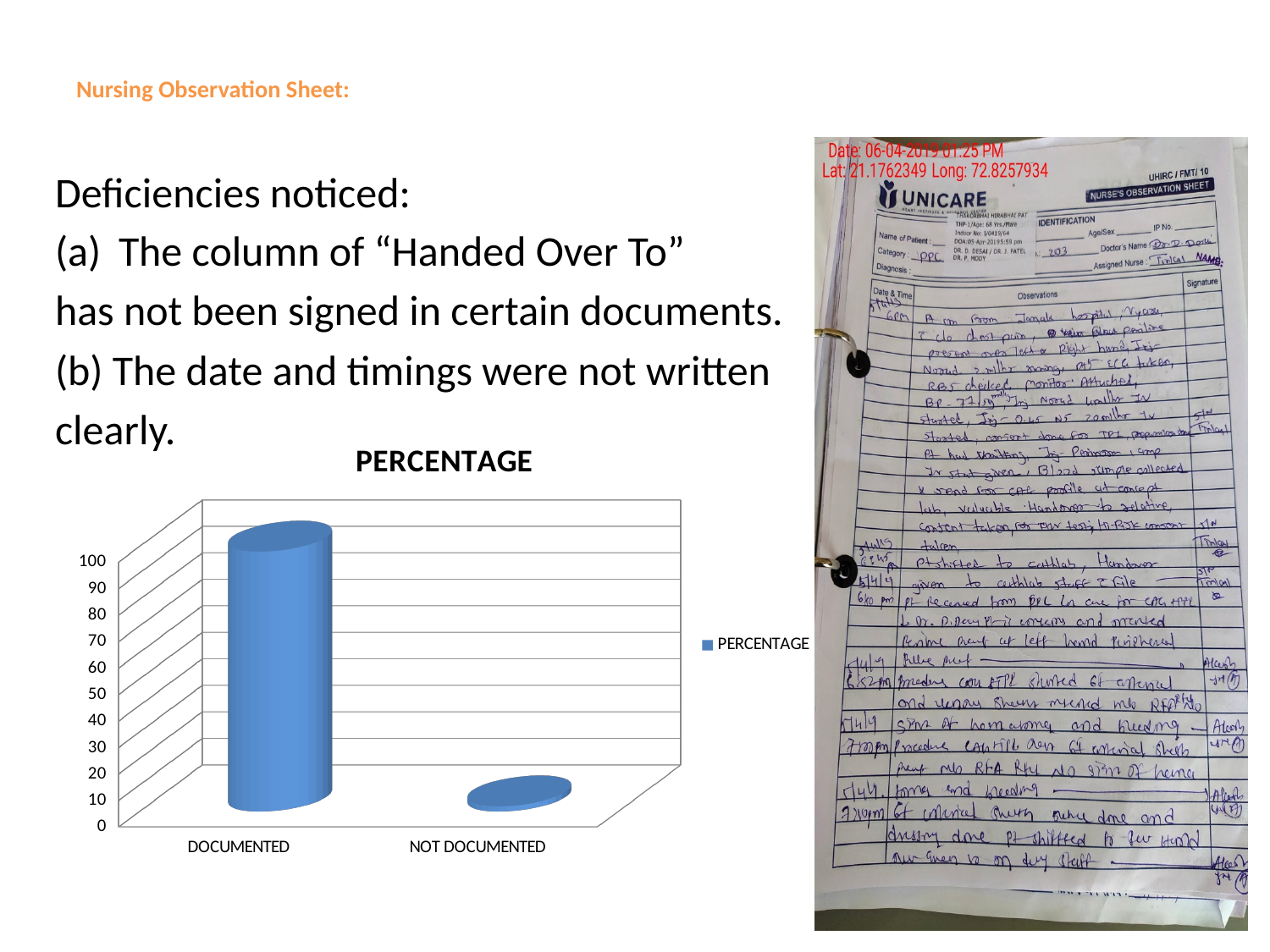
Which category has the highest value in the chart? DOCUMENTED Is the value for DOCUMENTED greater or less than 50? greater Is the value for DOCUMENTED greater or less than 80? greater What type of chart is shown on the slide? bar chart Is the value for NOT DOCUMENTED greater or less than 20? less How many series does the chart legend list? 1 Do the values rise or fall from DOCUMENTED to NOT DOCUMENTED along the x axis? fall How many categories are shown on the x axis of the chart? 2 Which category has the lowest value in the chart? NOT DOCUMENTED What is the name of the series listed in the chart legend? PERCENTAGE What is the title of the chart? PERCENTAGE Which is larger, the value for DOCUMENTED or the value for NOT DOCUMENTED? DOCUMENTED